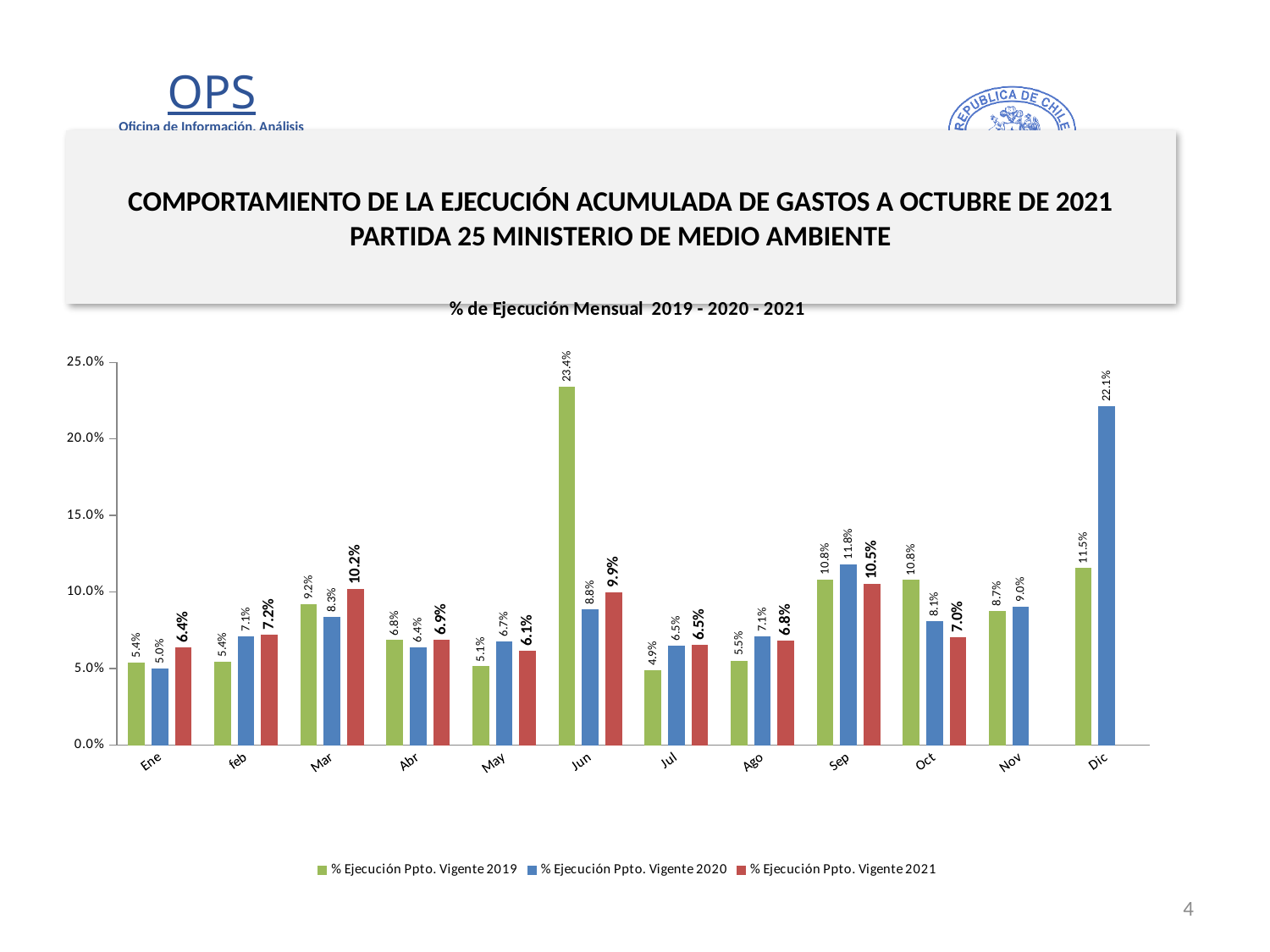
In which month is the % Ejecución Ppto. Vigente 2019 series highest? Jun What is the value for % Ejecución Ppto. Vigente 2021 in Mar? 10.2% What is the title of the chart? % de Ejecución Mensual 2019 - 2020 - 2021 What is the value for % Ejecución Ppto. Vigente 2021 in Sep? 10.5% What kind of chart is shown on the slide? Bar chart Which is larger in Oct: the 2019 value or the 2021 value? 2019 value (10.8%) How many series does the legend list? 3 How many months are shown on the x axis? 12 What is the difference between the 2020 and 2019 values in Dic? 10.6% In which month is the % Ejecución Ppto. Vigente 2021 series lowest? May What is the value for % Ejecución Ppto. Vigente 2020 in Dic? 22.1% What is the value for % Ejecución Ppto. Vigente 2019 in Jun? 23.4%